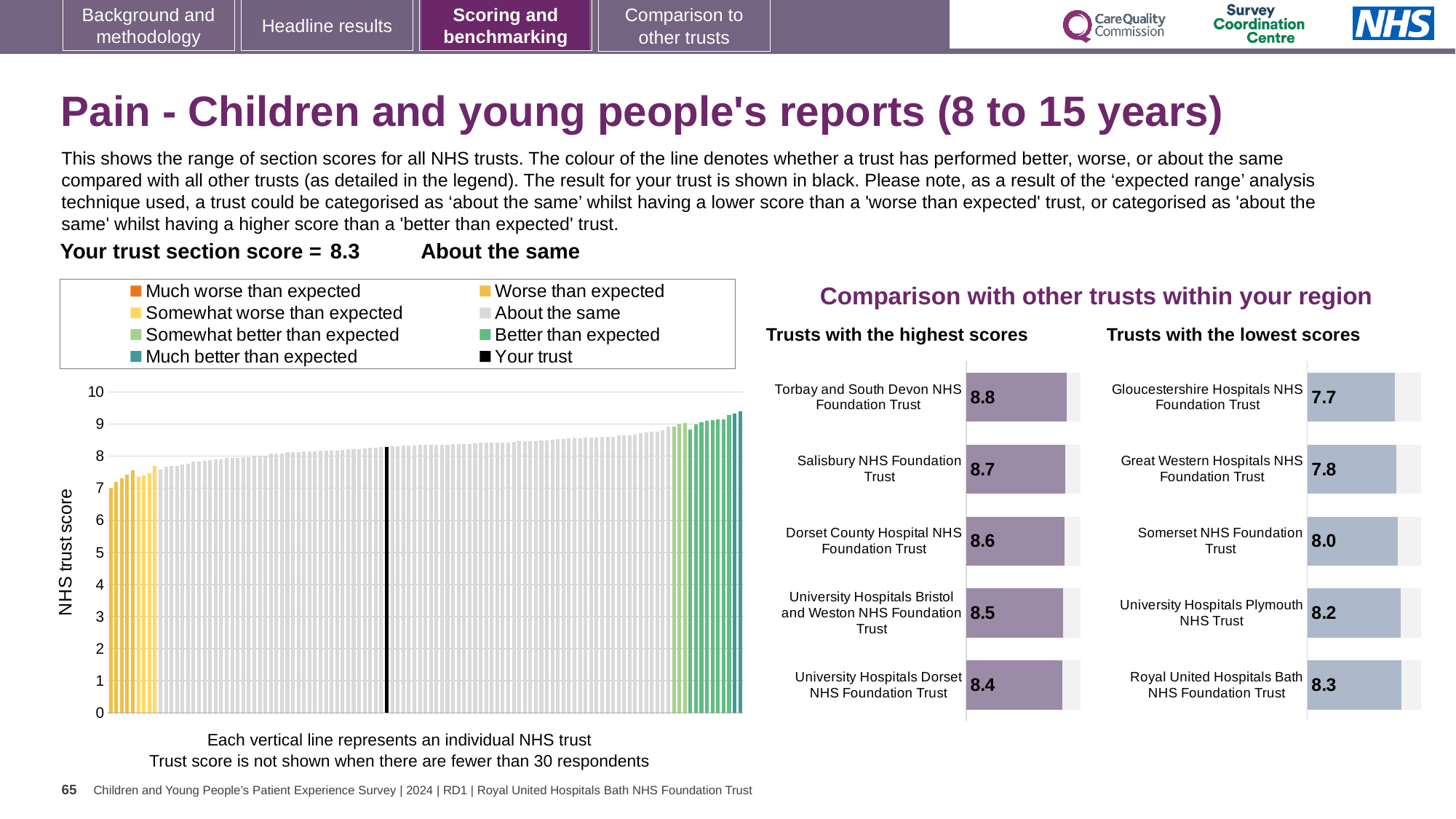
In the 'Trusts with the highest scores' chart, which trust has the lowest score shown? University Hospitals Dorset NHS Foundation Trust In the 'Trusts with the lowest scores' chart, which trust has the lowest score? Gloucestershire Hospitals NHS Foundation Trust In the 'Trusts with the highest scores' chart, what is the score for Torbay and South Devon NHS Foundation Trust? 8.8 In the large 'NHS trust score' chart on the left, do the values rise or fall from left to right? rise Which is larger: the score for Salisbury NHS Foundation Trust in the 'Trusts with the highest scores' chart or the score for Great Western Hospitals NHS Foundation Trust in the 'Trusts with the lowest scores' chart? Salisbury NHS Foundation Trust In the large 'NHS trust score' chart on the left, is the value of the leftmost bar greater or less than 8? less In the 'Trusts with the lowest scores' chart, what is the difference between the scores of Royal United Hospitals Bath NHS Foundation Trust and Gloucestershire Hospitals NHS Foundation Trust? 0.6 How many entries does the legend of the large 'NHS trust score' chart list? 8 In the 'Trusts with the highest scores' chart, what is the difference between the scores of Torbay and South Devon NHS Foundation Trust and University Hospitals Dorset NHS Foundation Trust? 0.4 In the 'Trusts with the lowest scores' chart, what is the score for Somerset NHS Foundation Trust? 8.0 In the 'Trusts with the lowest scores' chart, which trust has the highest score shown? Royal United Hospitals Bath NHS Foundation Trust How many trusts are listed in the 'Trusts with the highest scores' chart? 5